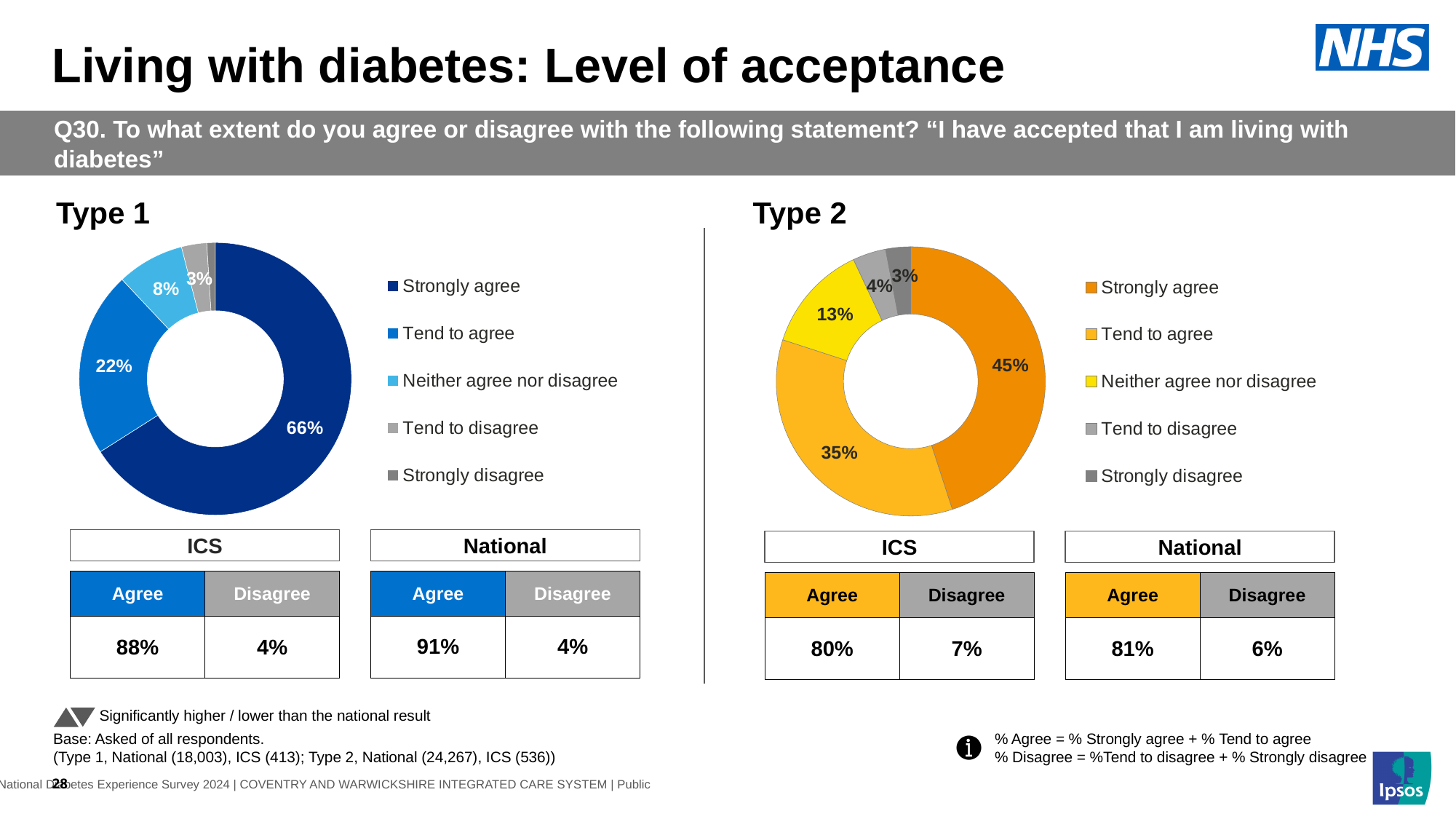
In the Type 2 chart, what is the difference between the strongly agree and tend to agree shares? 10 percentage points In the Type 1 chart, what percentage of respondents said they tend to agree? 22% In the Type 2 chart, what percentage of respondents said they neither agree nor disagree? 13% Which chart has a larger strongly agree share, Type 1 or Type 2? Type 1 In the Type 1 chart, what percentage of respondents said they strongly agree? 66% In the Type 1 chart, what is the difference between the strongly agree and tend to agree shares? 44 percentage points In the Type 2 chart, which response category has the largest share? Strongly agree How many response categories does the legend of the Type 2 chart list? 5 In the Type 2 chart, what percentage of respondents said they strongly agree? 45% In the Type 2 chart, what percentage of respondents said they strongly disagree? 3% What kind of chart is used for the Type 1 results? Donut (pie) chart In the Type 1 chart, which response category has the largest share? Strongly agree